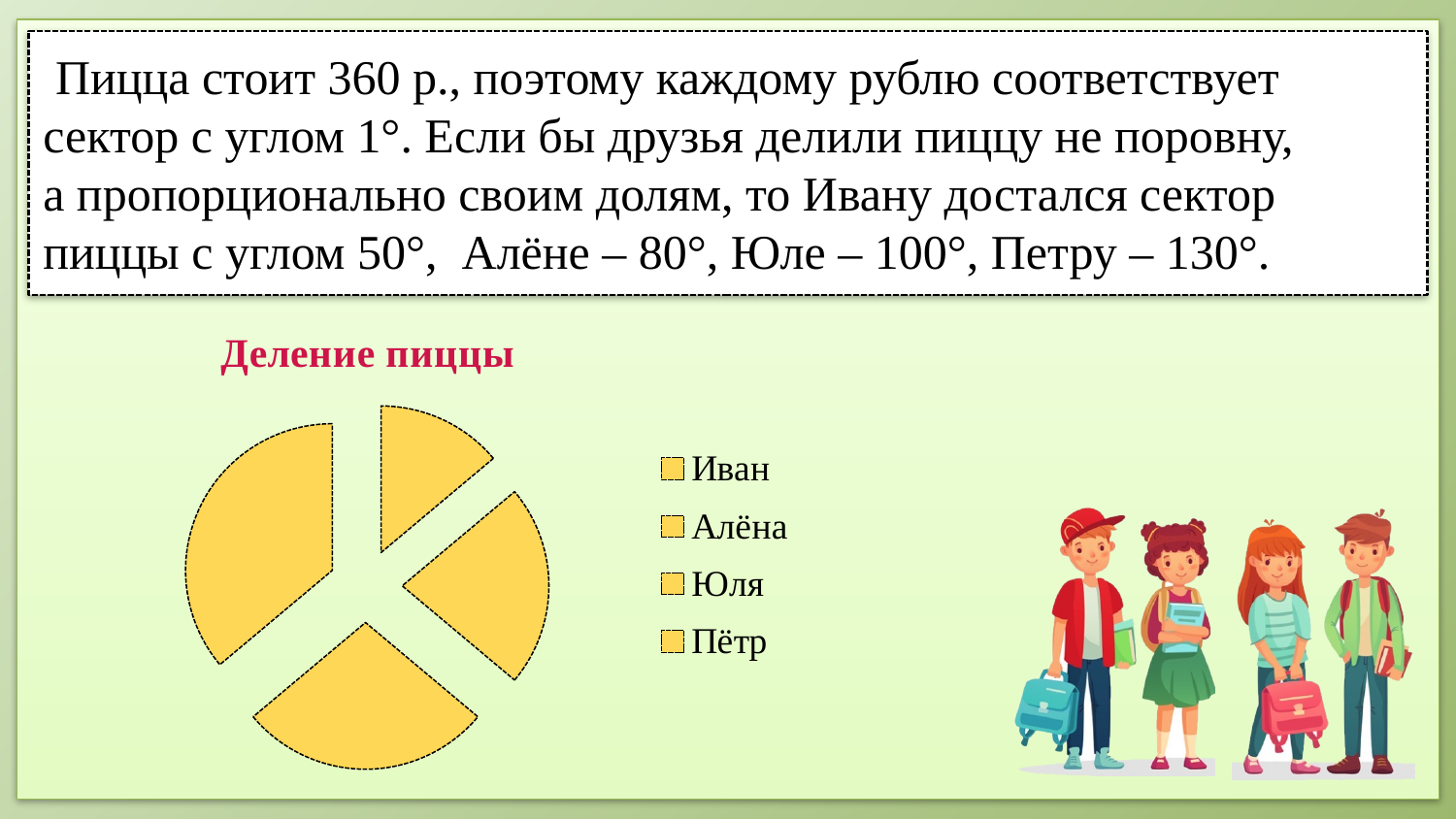
How many slices does the pie chart "Деление пиццы" have? 4 Which person has the smallest slice of the pizza in the pie chart? Иван Which names are listed in the legend of the pie chart? Иван, Алёна, Юля, Пётр Whose slice of the pizza is larger, Алёна's or Юля's? Юля Which person has the largest slice of the pizza in the pie chart? Пётр How many entries does the legend of the pie chart list? 4 What kind of chart is shown under the title "Деление пиццы"? pie chart What is the title of the pie chart? Деление пиццы